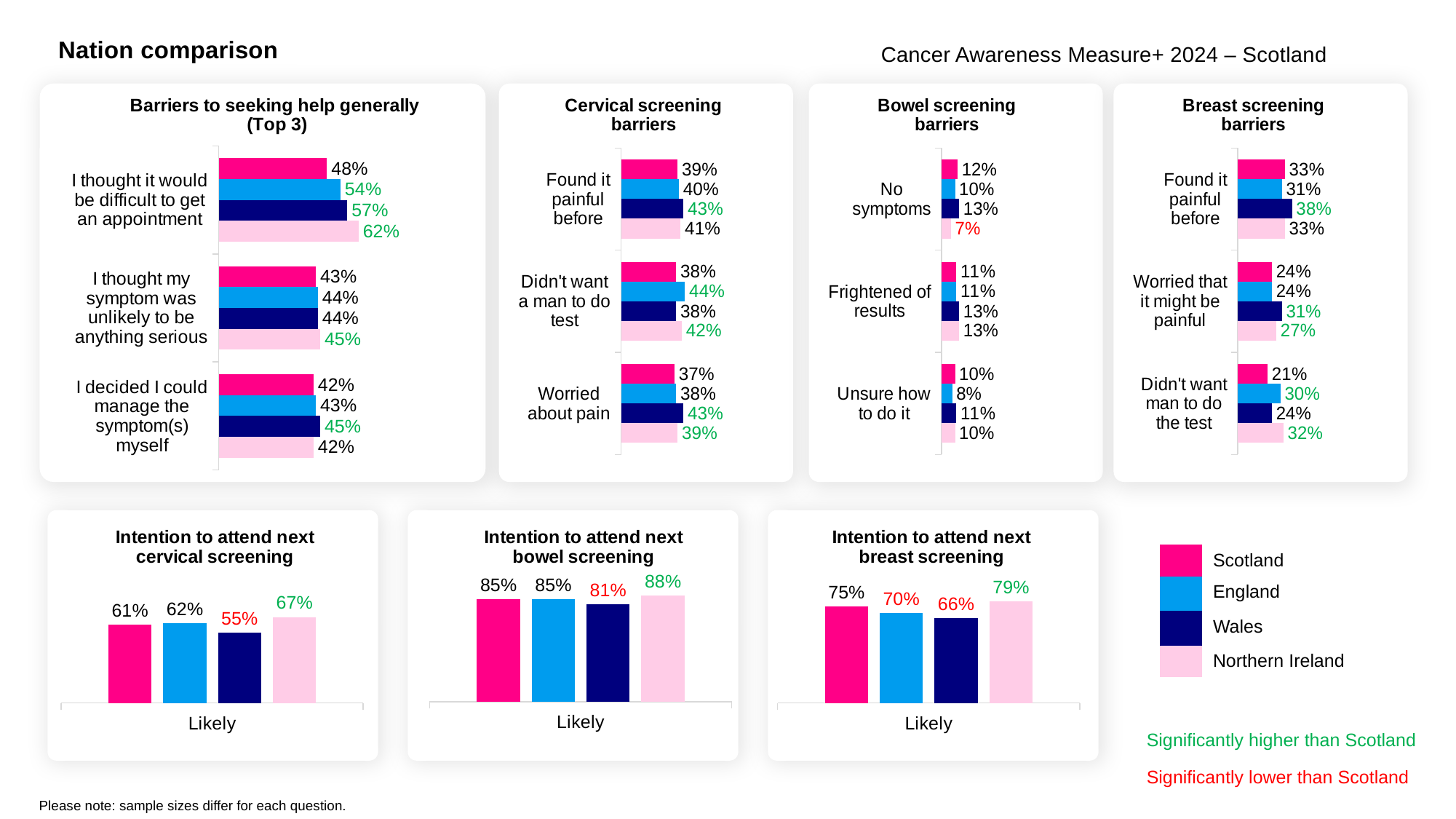
In the 'Bowel screening barriers' chart, which nation has the lowest value for 'No symptoms'? Northern Ireland What kind of chart is the 'Cervical screening barriers' chart? Bar chart In the 'Bowel screening barriers' chart, what is the value for Wales for 'Unsure how to do it'? 11% In the 'Intention to attend next breast screening' chart, is the value for Scotland or Wales larger? Scotland In the 'Cervical screening barriers' chart, what is the value for England for 'Didn't want a man to do test'? 44% In the 'Intention to attend next bowel screening' chart, which nation has the highest value? Northern Ireland In the 'Intention to attend next cervical screening' chart, what is the difference between the Northern Ireland and Wales values? 12% In the 'Breast screening barriers' chart, which nation has the highest value for 'Found it painful before'? Wales In the 'Intention to attend next breast screening' chart, what is the value for England? 70% Which nation is shown in dark blue in the legend? Wales How many nations does the legend list? 4 In the 'Barriers to seeking help generally (Top 3)' chart, what is the value for Northern Ireland for 'I thought it would be difficult to get an appointment'? 62%